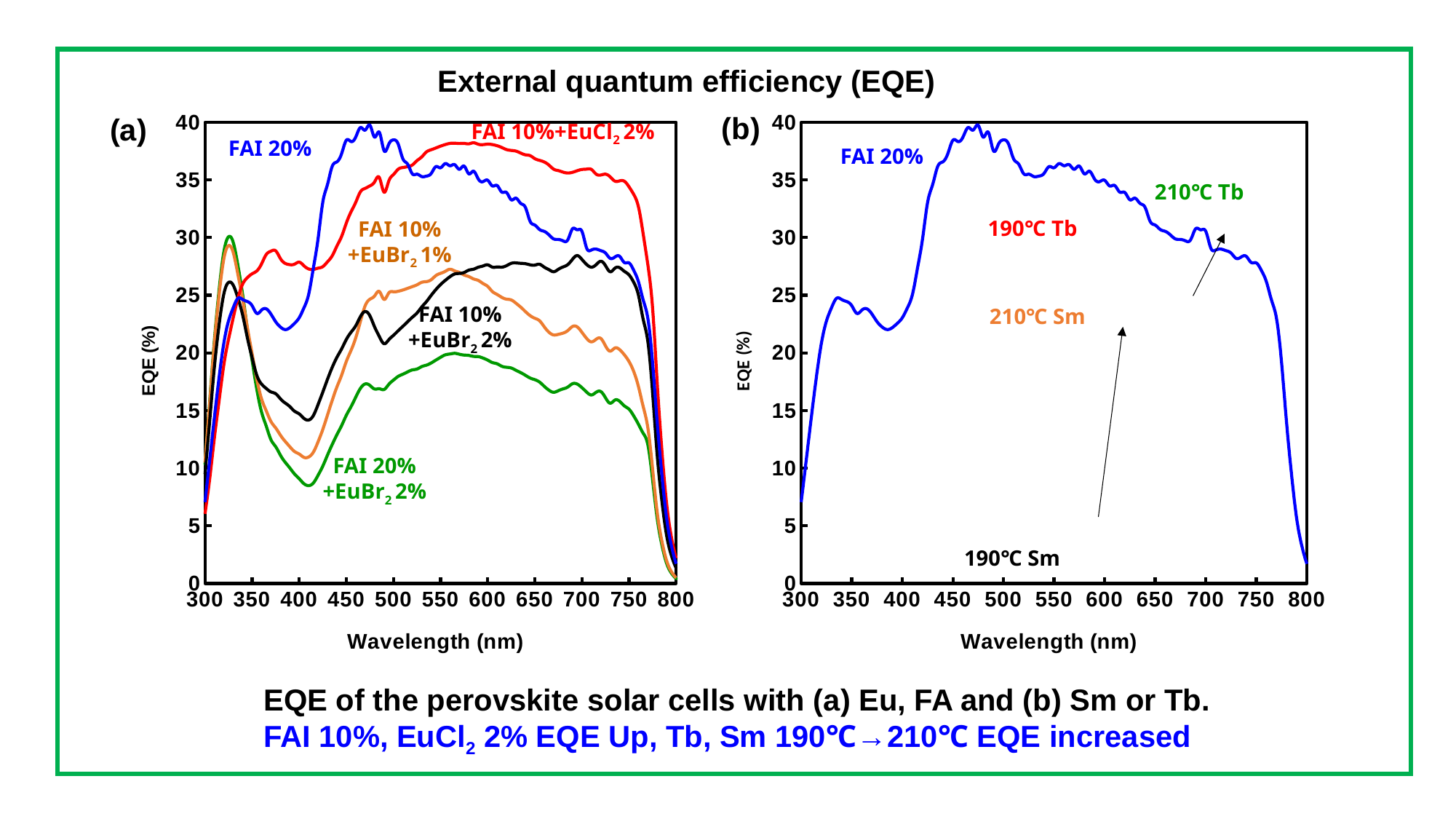
What is the x-axis label of chart (a)? Wavelength (nm) In chart (b), does the FAI 20% curve rise or fall between 500 nm and 750 nm? fall In chart (a), is the EQE of the FAI 20%+EuBr2 2% curve at 600 nm greater or less than 25? less In chart (b), is the EQE of the FAI 20% curve at 800 nm greater or less than 5? less In chart (a), which curve has the lowest EQE at 600 nm? FAI 20%+EuBr2 2% In chart (a), at 400 nm, which curve has the higher EQE: FAI 20% or FAI 20%+EuBr2 2%? FAI 20% In chart (a), which curve has the highest EQE at 600 nm? FAI 10%+EuCl2 2% How many curves are actually plotted in chart (b)? 1 How many curves are plotted in chart (a)? 5 What kind of chart is chart (a)? line chart In chart (a), is the EQE of the FAI 10%+EuCl2 2% curve at 600 nm greater or less than 35? greater